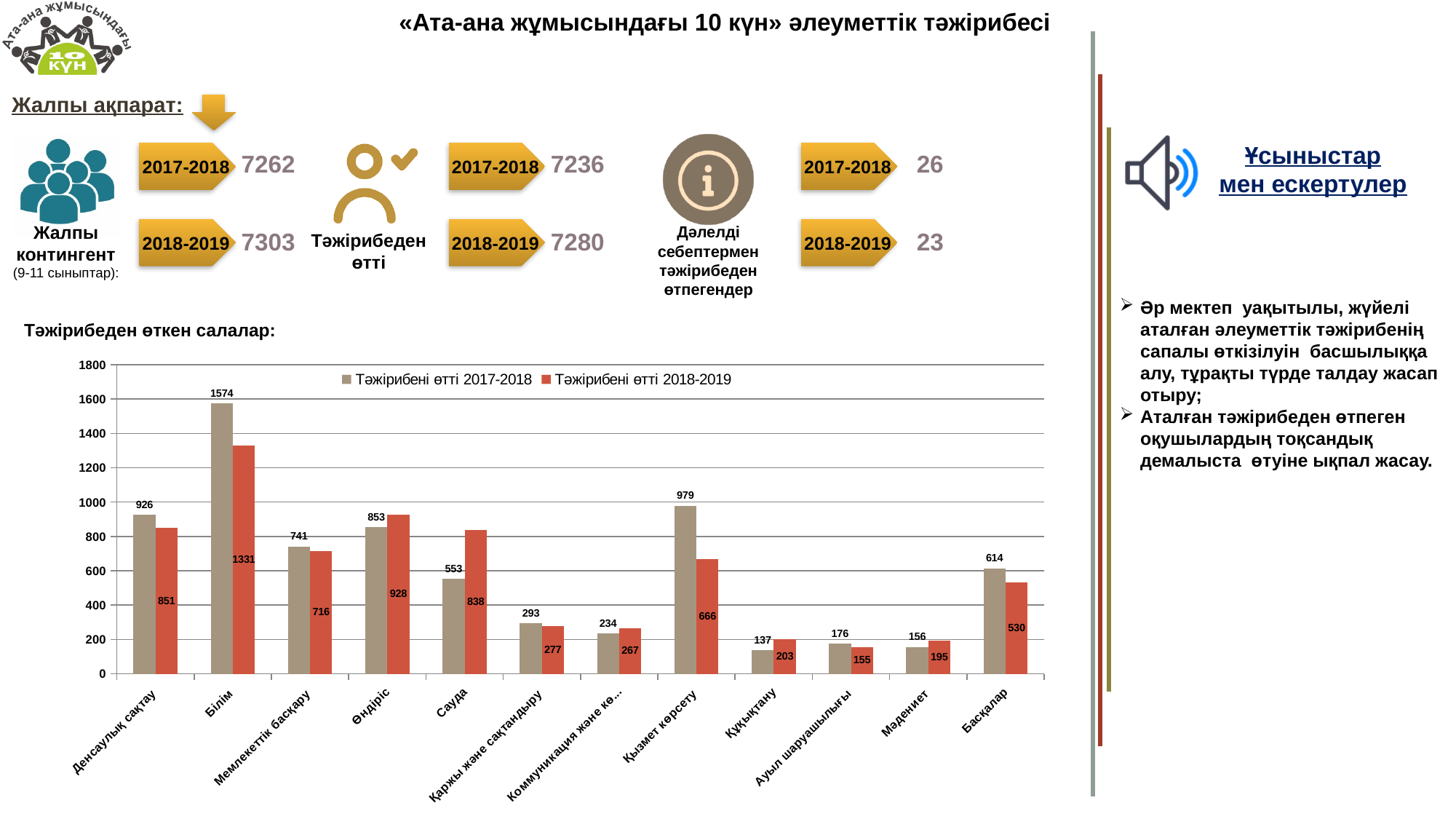
Is the value for Басқалар in the series Тәжірибені өтті 2018-2019 greater or less than 600? less Which category has the highest value in the series Тәжірибені өтті 2018-2019? Білім Which category has the lowest value in the series Тәжірибені өтті 2017-2018? Құқықтану How many categories are shown on the x axis of the chart? 12 What is the value for Білім in the series Тәжірибені өтті 2017-2018? 1574 How many series does the chart legend list? 2 What is the difference between the 2017-2018 and 2018-2019 values for Білім? 243 What is the value for Сауда in the series Тәжірибені өтті 2018-2019? 838 What type of chart is shown on the slide? bar chart What is the value for Қызмет көрсету in the series Тәжірибені өтті 2017-2018? 979 Which is larger for Өндіріс: the 2017-2018 value or the 2018-2019 value? 2018-2019 What is the title of the section above the chart? Тәжірибеден өткен салалар: